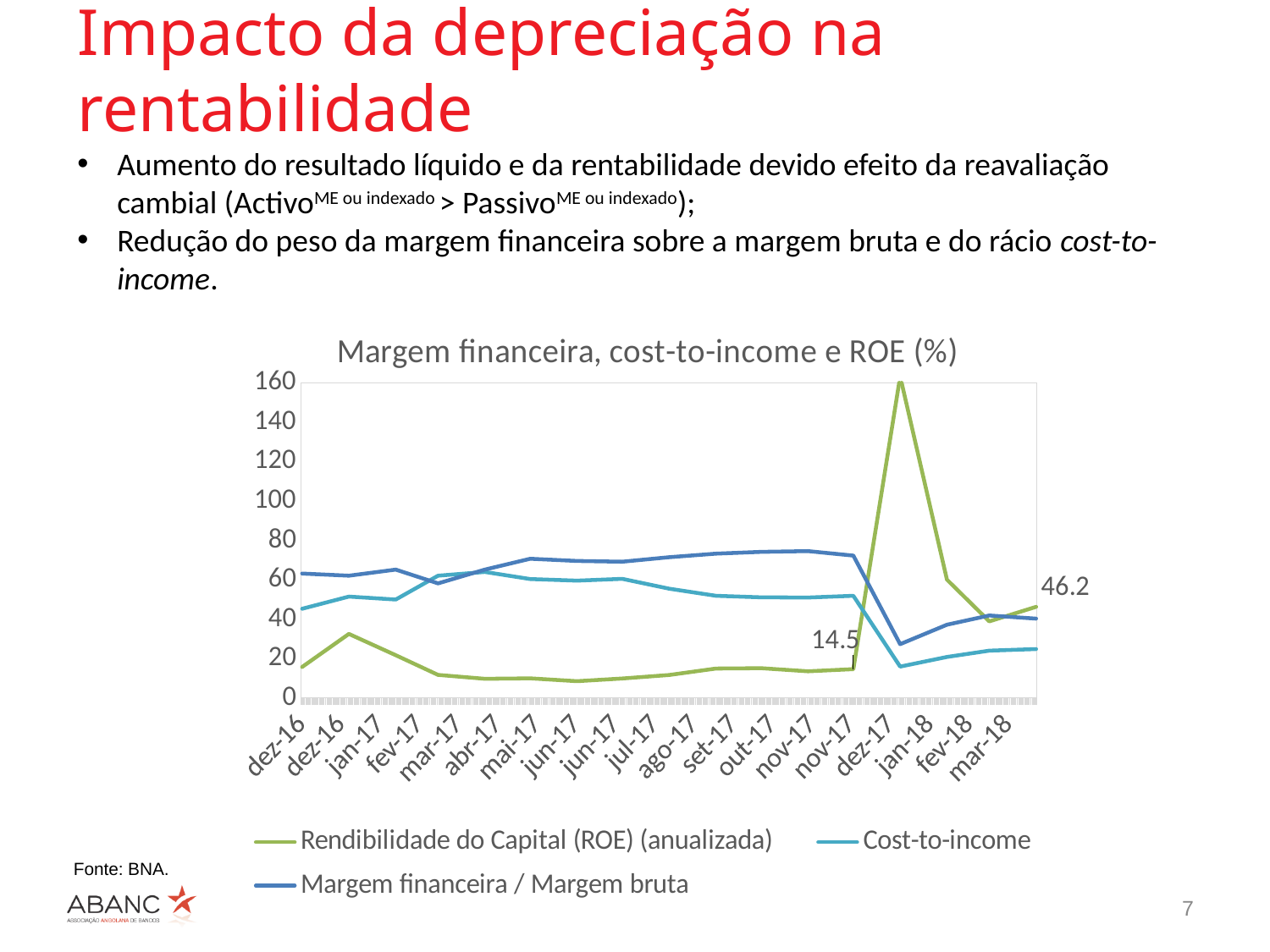
What kind of chart is shown on the slide? line chart What is the title of the chart? Margem financeira, cost-to-income e ROE (%) Is the value of Margem financeira / Margem bruta at out-17 greater or less than 60? greater In which month does Rendibilidade do Capital (ROE) (anualizada) reach its highest value? dez-17 At nov-17, which is larger: Margem financeira / Margem bruta or Rendibilidade do Capital (ROE) (anualizada)? Margem financeira / Margem bruta What is the value of Rendibilidade do Capital (ROE) (anualizada) at nov-17 (the labelled point)? 14.5 What is the difference between the ROE value labelled 46.2 at mar-18 and the ROE value labelled 14.5 at nov-17? 31.7 Is the value of Rendibilidade do Capital (ROE) (anualizada) at dez-17 greater or less than 140? greater What is the value of Rendibilidade do Capital (ROE) (anualizada) at mar-18? 46.2 How many series does the chart's legend list? 3 Does Rendibilidade do Capital (ROE) (anualizada) rise or fall from dez-17 to fev-18? fall